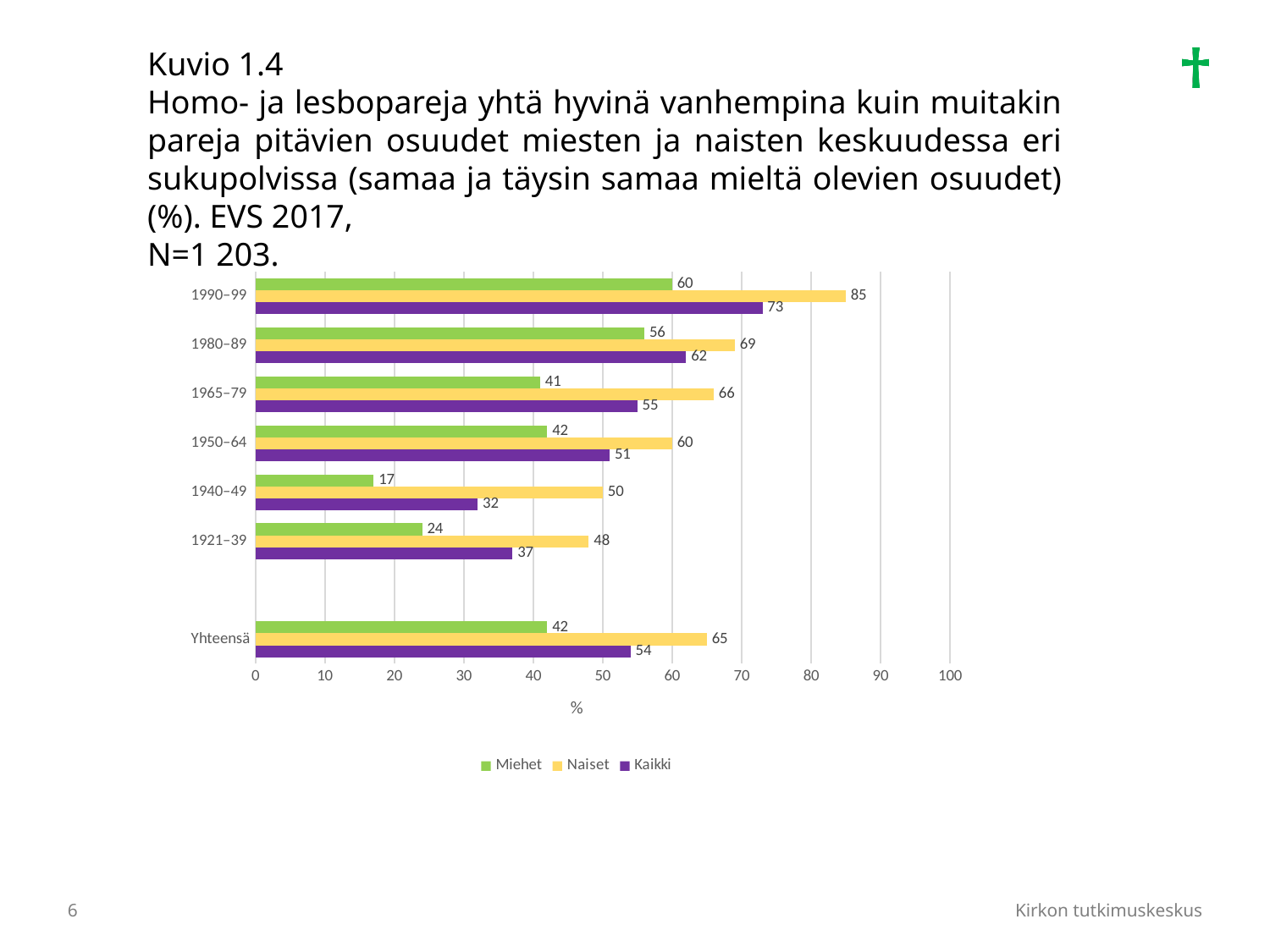
Which category has the highest value for Naiset? 1990–99 Which is larger: the Miehet value for 1950–64 or the Miehet value for 1965–79? 1950–64 What is the label on the horizontal axis? % Which category has the lowest value for Miehet? 1940–49 What is the value for Miehet in the 1940–49 category? 17 What is the difference between the Naiset and Miehet values in the 1940–49 category? 33 What kind of chart is shown on the slide? Bar chart What is the value for Naiset in the 1990–99 category? 85 Which series is shown in purple? Kaikki What is the value for Kaikki in the Yhteensä category? 54 How many series does the legend list? 3 How many categories are shown on the vertical axis? 7